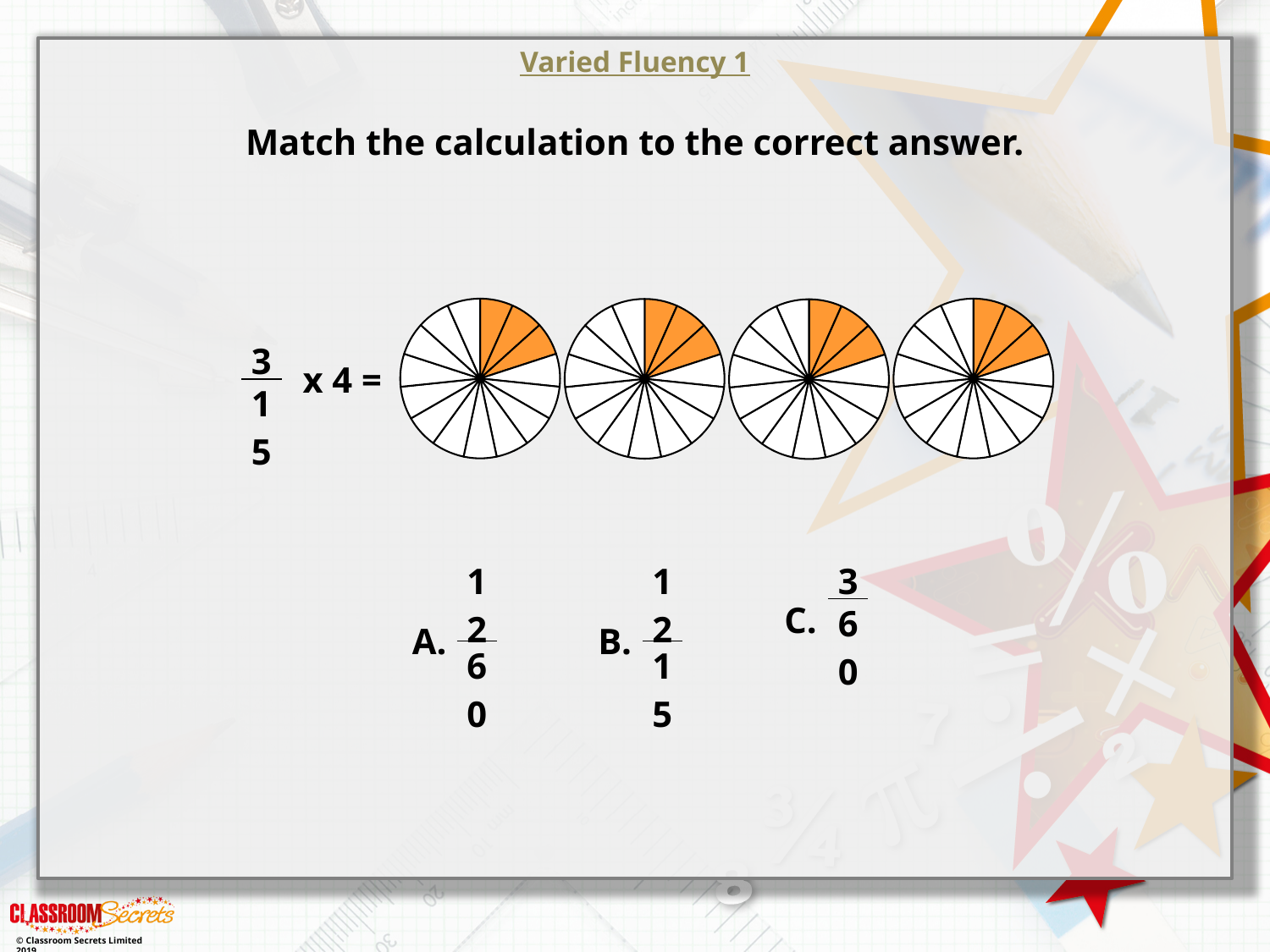
How many segments are shaded orange in each circle diagram? 3 In each circle diagram, are more segments shaded or unshaded? Unshaded What colour are the shaded segments in the circle diagrams? Orange What fraction of each circle diagram is shaded, as written in the calculation on the slide? 3/15 How many circle diagrams are shown on the slide? 4 Into how many equal segments is each circle diagram divided? 15